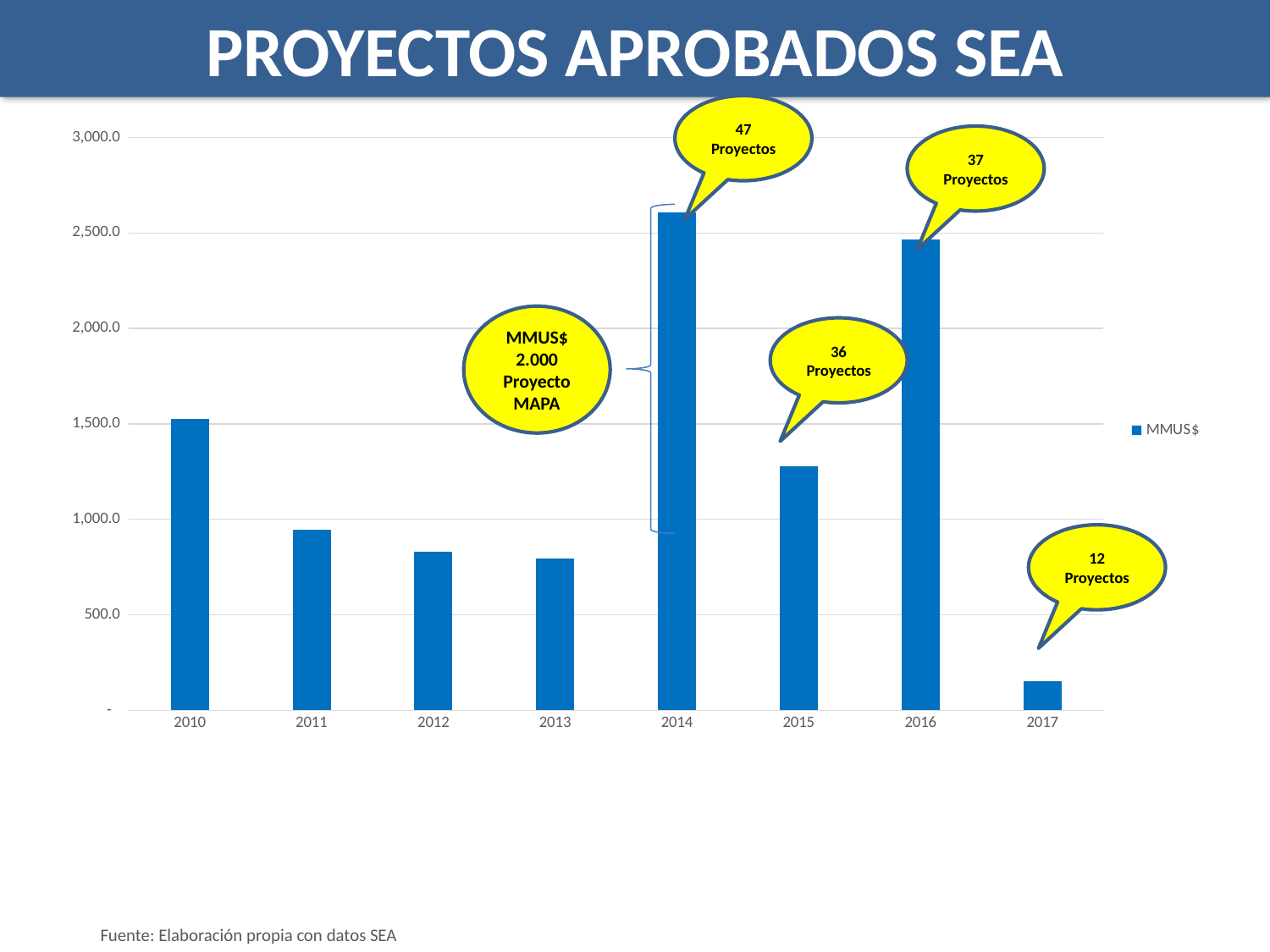
How many years are shown on the x axis of the chart? 8 Do the values rise or fall from 2010 to 2013? fall Which year has a larger value, 2015 or 2016? 2016 Which year has the lowest bar in the chart? 2017 Which year has a larger value, 2010 or 2011? 2010 Is the value for 2014 greater or less than 2,500.0? greater Which year has the highest bar in the chart? 2014 Is the value for 2017 greater or less than 500.0? less What is the series name shown in the chart legend? MMUS$ What kind of chart is shown on the slide? bar chart Is the value for 2011 greater or less than 1,000.0? less How many series does the chart legend list? 1